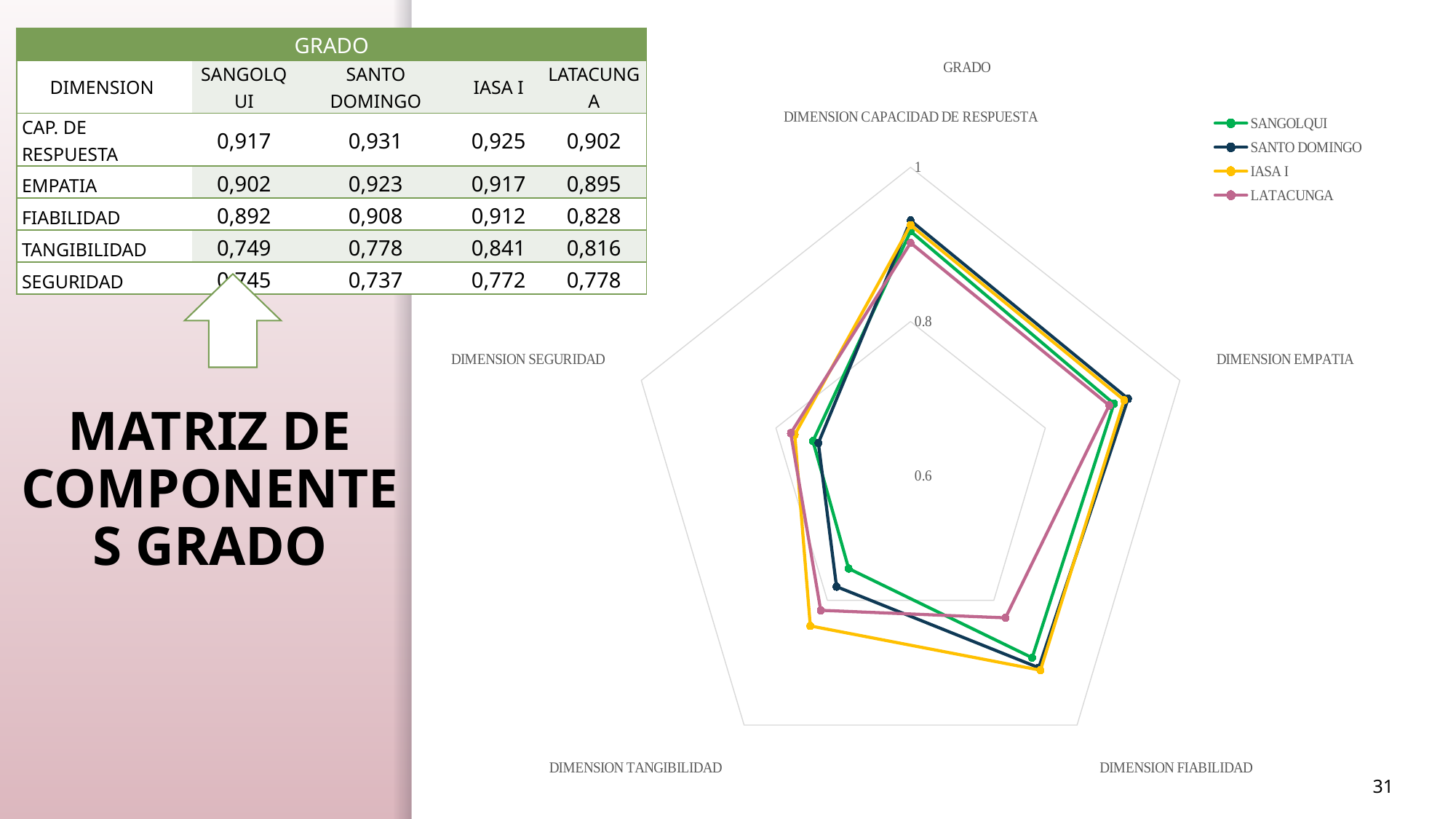
What kind of chart is shown on the slide? Radar chart What is the title of the radar chart? GRADO Which series has the highest value on DIMENSION TANGIBILIDAD? IASA I Is the value for SANTO DOMINGO on DIMENSION EMPATIA greater or less than 0.8? greater How many dimensions (axes) does the GRADO radar chart have? 5 Is the value for SANGOLQUI on DIMENSION TANGIBILIDAD greater or less than 0.8? less What is the difference between IASA I and SANGOLQUI on DIMENSION TANGIBILIDAD? 0,092 What is the value for SANTO DOMINGO on DIMENSION CAPACIDAD DE RESPUESTA? 0,931 What is the value for IASA I on DIMENSION TANGIBILIDAD? 0,841 Which series has the lowest value on DIMENSION FIABILIDAD? LATACUNGA Which is larger on DIMENSION SEGURIDAD, SANGOLQUI or LATACUNGA? LATACUNGA How many series does the legend of the GRADO chart list? 4